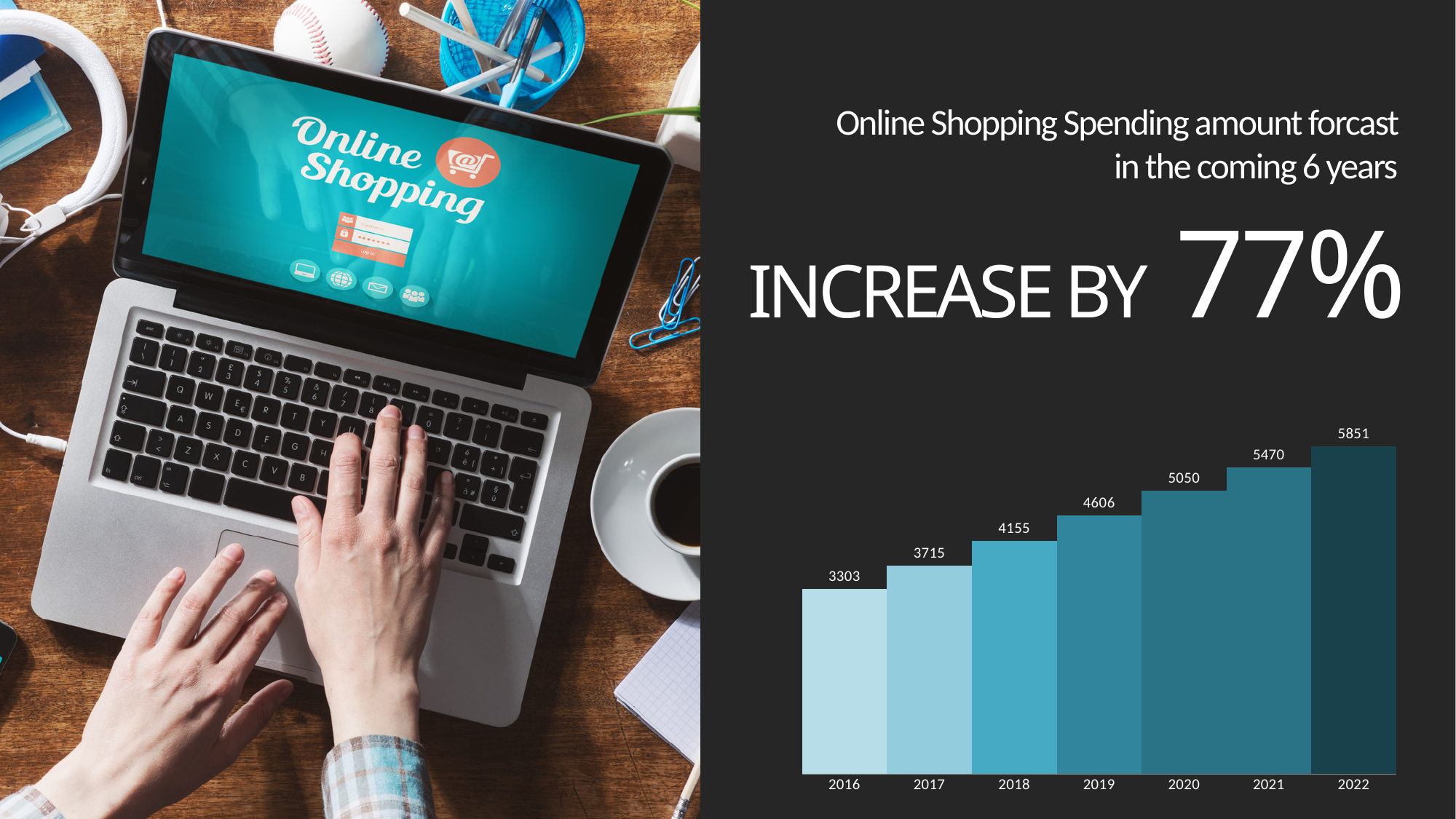
Which year has the lowest value? 2016 What is the value for 2022? 5851 How many years are shown on the x axis? 7 What is the difference between the values for 2022 and 2016? 2548 Do the values rise or fall from 2016 to 2022? Rise Which is larger, the value for 2020 or the value for 2019? 2020 What percentage increase is stated in the headline above the chart? 77% Which year has the highest value? 2022 What is the value for 2019? 4606 What is the value for 2016? 3303 What kind of chart is shown on the slide? Bar chart What is the difference between the values for 2018 and 2017? 440